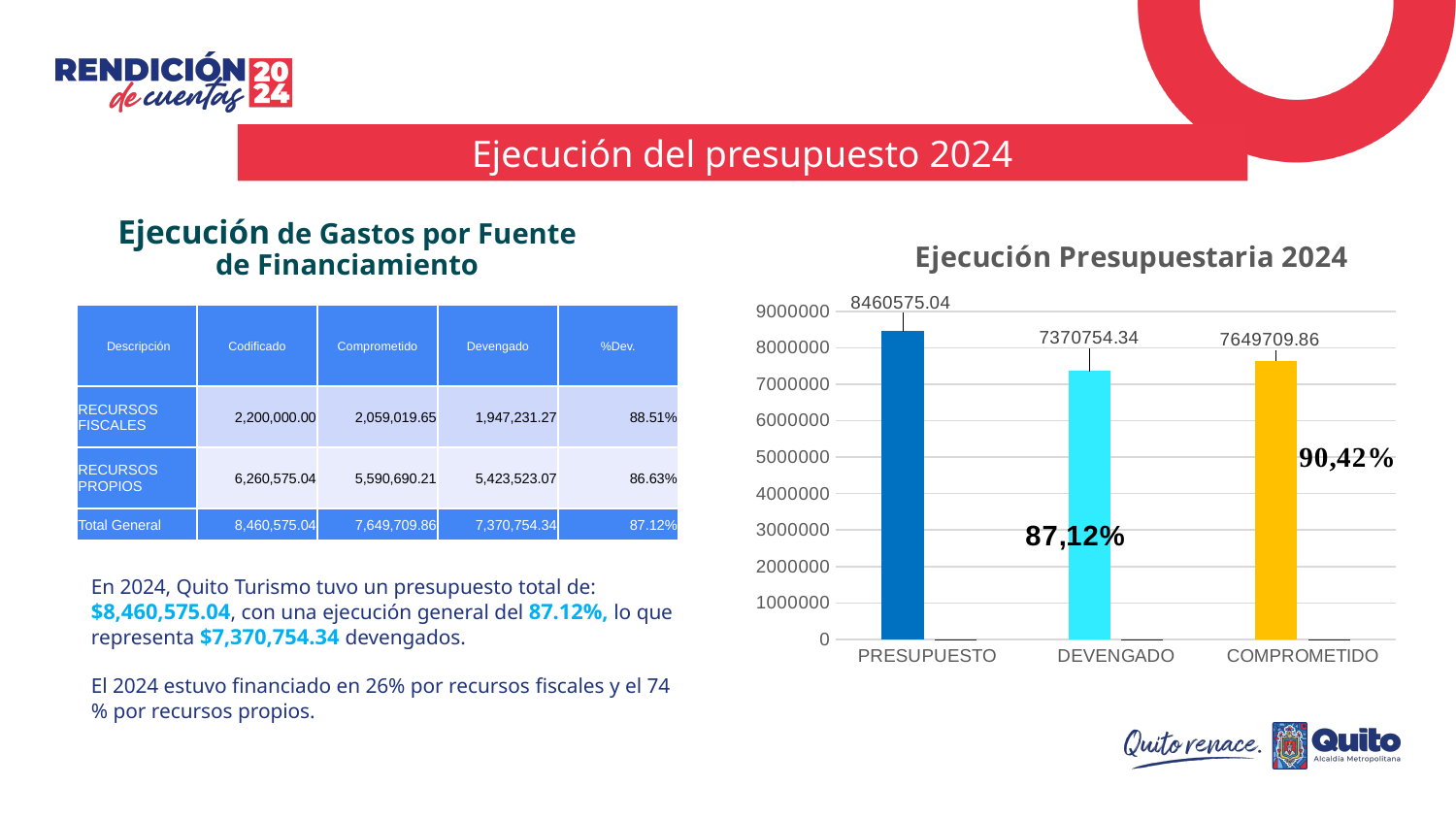
What is the difference between the COMPROMETIDO and DEVENGADO values in the Ejecución Presupuestaria 2024 chart? 278955.52 Is the value for DEVENGADO in the Ejecución Presupuestaria 2024 chart greater or less than 8000000? less What is the difference between the PRESUPUESTO and DEVENGADO values in the Ejecución Presupuestaria 2024 chart? 1089820.70 How many categories are shown in the Ejecución Presupuestaria 2024 chart? 3 What is the value for COMPROMETIDO in the Ejecución Presupuestaria 2024 chart? 7649709.86 Which is larger in the Ejecución Presupuestaria 2024 chart, COMPROMETIDO or DEVENGADO? COMPROMETIDO What is the value for PRESUPUESTO in the Ejecución Presupuestaria 2024 chart? 8460575.04 Which category has the highest value in the Ejecución Presupuestaria 2024 chart? PRESUPUESTO What percentage label is shown next to the COMPROMETIDO bar in the Ejecución Presupuestaria 2024 chart? 90,42% Which category has the lowest value in the Ejecución Presupuestaria 2024 chart? DEVENGADO What kind of chart is the Ejecución Presupuestaria 2024 chart? bar chart What is the value for DEVENGADO in the Ejecución Presupuestaria 2024 chart? 7370754.34